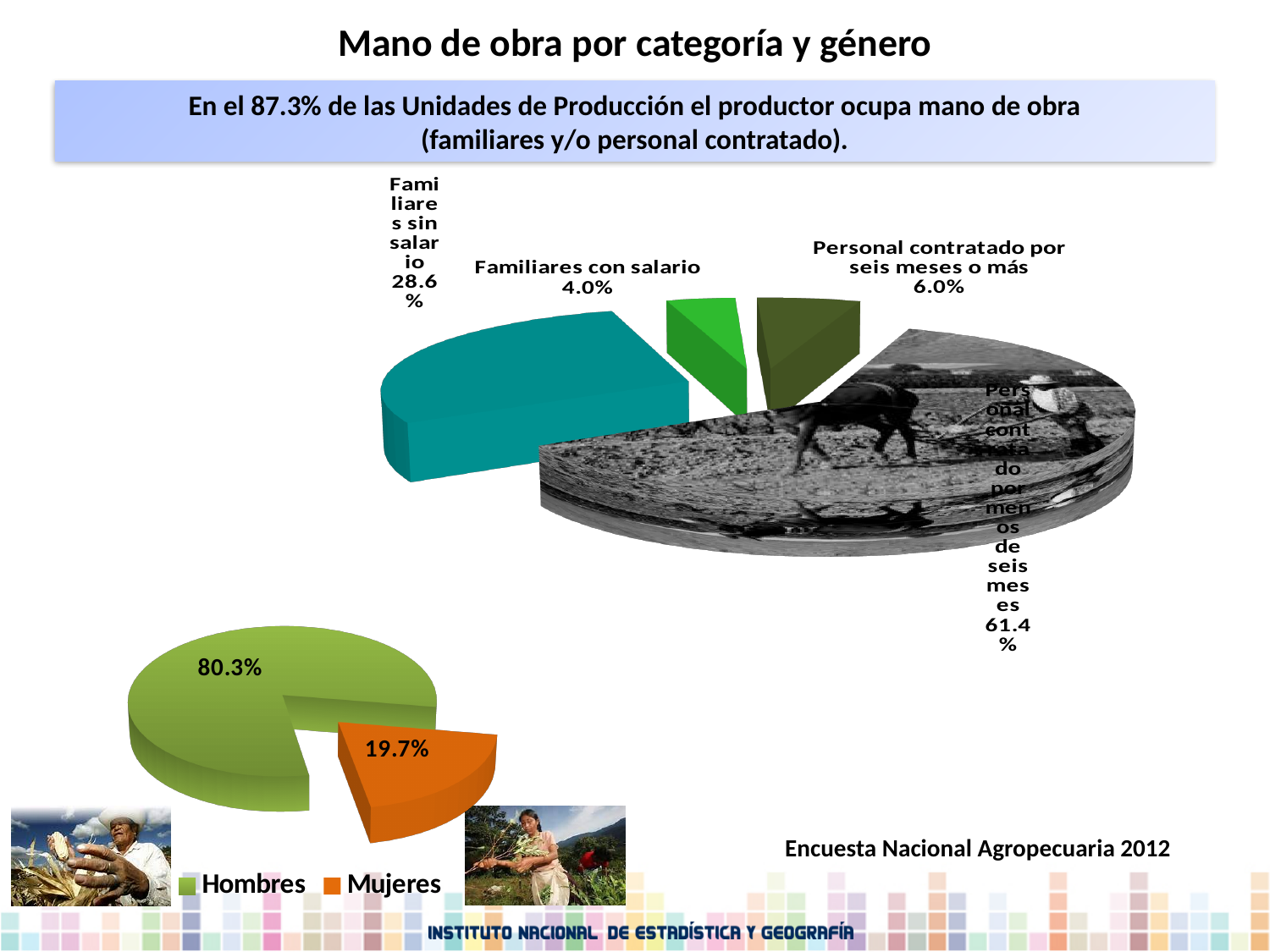
In the upper pie chart, which category has the smallest share? Familiares con salario In the lower pie chart, which is larger, Hombres or Mujeres? Hombres In the upper pie chart, what share is labelled for Personal contratado por menos de seis meses? 61.4% In the upper pie chart, which category has the largest share? Personal contratado por menos de seis meses In the lower pie chart, what share is labelled for Hombres? 80.3% In the lower pie chart, what share is labelled for Mujeres? 19.7% In the upper pie chart, what is the difference between the shares of Familiares sin salario and Personal contratado por seis meses o más? 22.6% In the upper pie chart, what share is labelled for Familiares con salario? 4.0% What type of chart is the lower chart on the slide? Pie chart In the upper pie chart, what share is labelled for Familiares sin salario? 28.6% In the upper pie chart, what share is labelled for Personal contratado por seis meses o más? 6.0% In the upper pie chart, how many categories are shown? 4